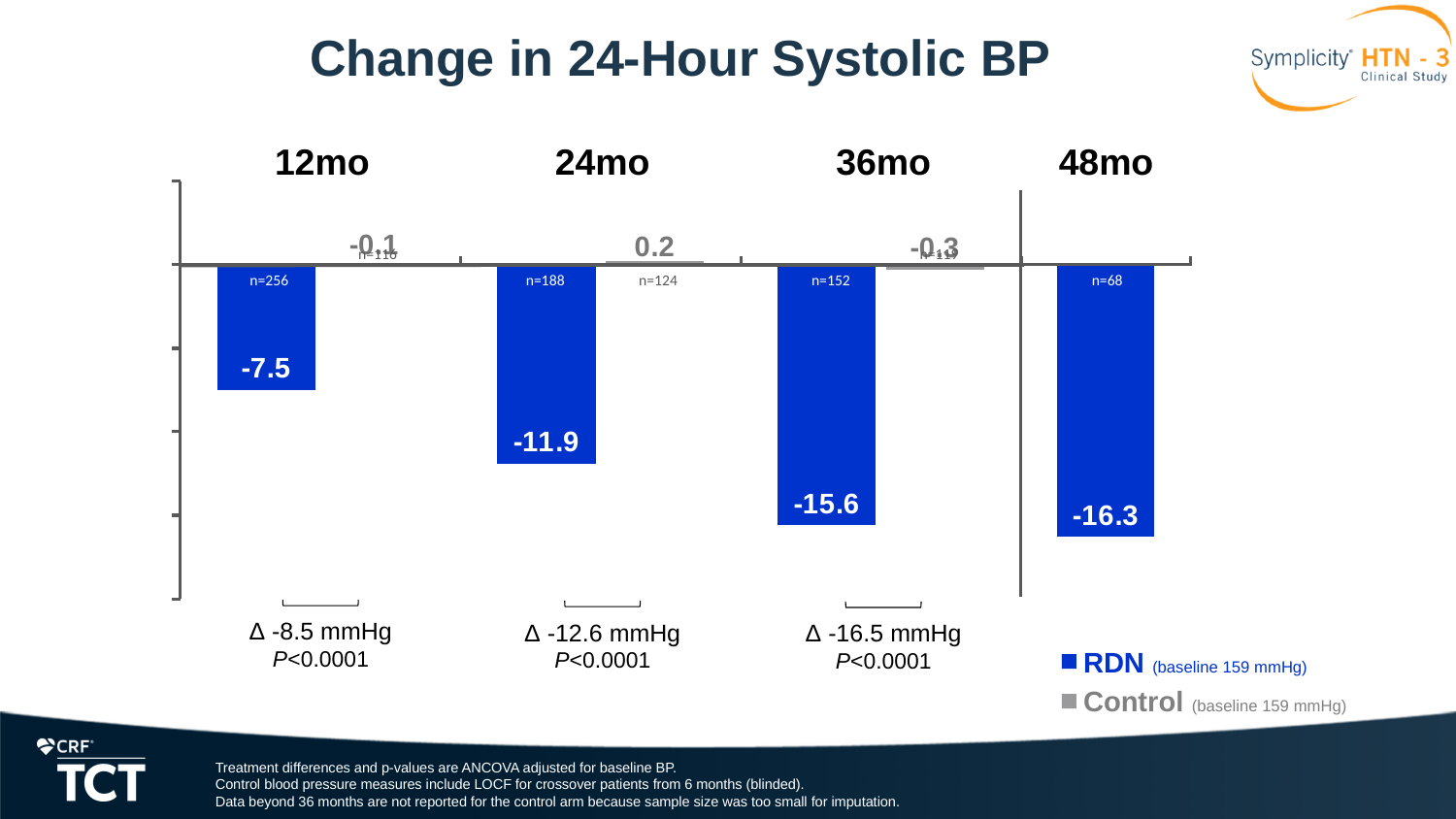
What is the change in 24-hour systolic BP for the Control group at 24 months? 0.2 At which time point does the RDN group show the smallest reduction in 24-hour systolic BP? 12mo What kind of chart is shown on the slide? Bar chart At which time point does the RDN group show the largest reduction in 24-hour systolic BP? 48mo What is the difference between the RDN change at 48 months (-16.3) and at 12 months (-7.5)? 8.8 What is the change in 24-hour systolic BP for the RDN group at 12 months? -7.5 How many time points are shown on the x axis of the chart? 4 What is the change in 24-hour systolic BP for the RDN group at 36 months? -15.6 Which group shows a larger reduction in 24-hour systolic BP at 36 months, RDN or Control? RDN Does the RDN change in 24-hour systolic BP become more negative or less negative from 12 months to 48 months? More negative How many series does the legend list? 2 What is the change in 24-hour systolic BP for the RDN group at 48 months? -16.3